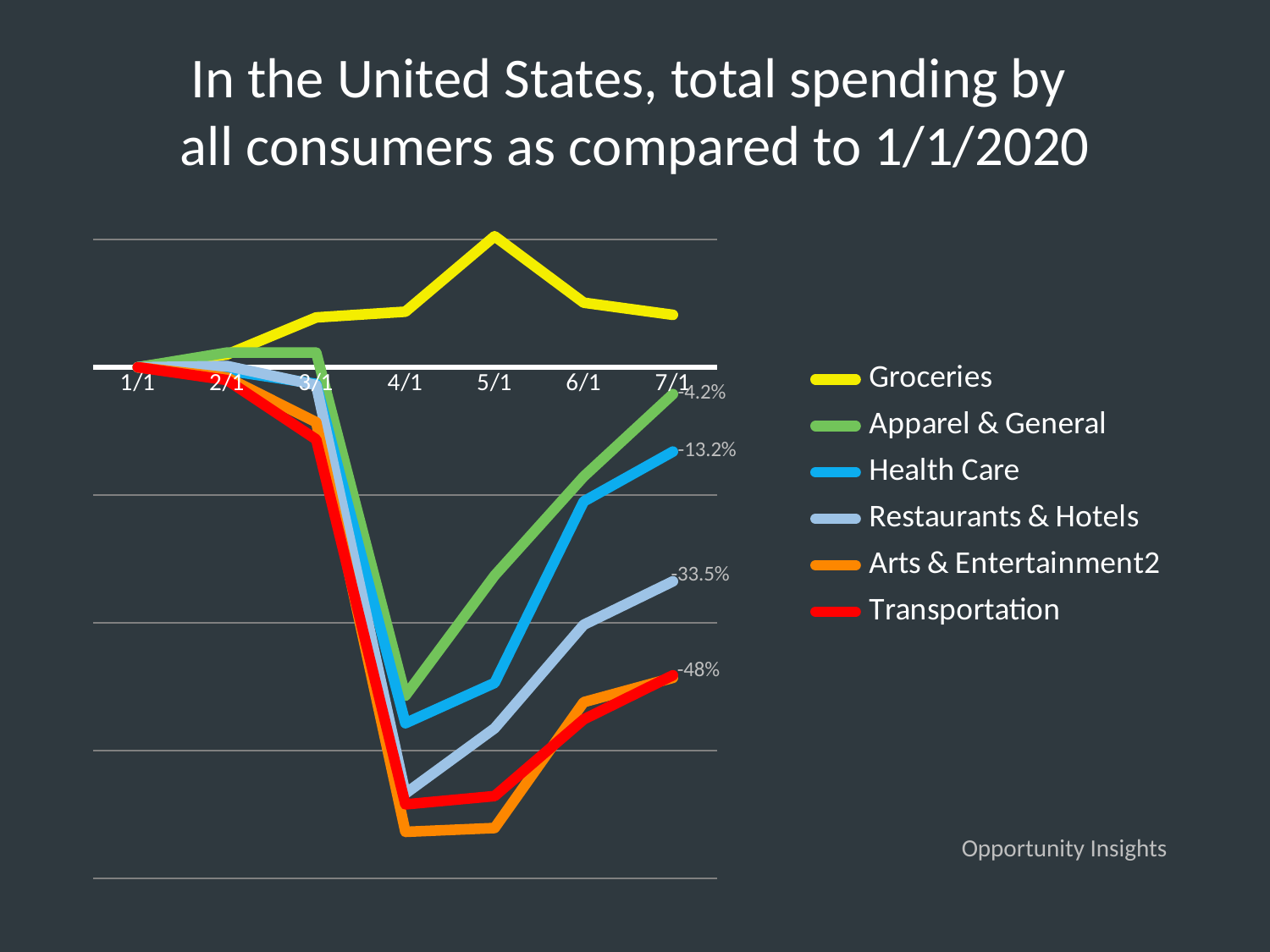
What is the value for Restaurants & Hotels at 7/1? -33.5% Which series has the lowest value at 4/1? Arts & Entertainment2 How many series does the legend list? 6 How many dates are shown along the x axis? 7 At 7/1, which is higher: Apparel & General or Health Care? Apparel & General Which series has the highest value at 5/1? Groceries Does the Health Care line rise or fall from 4/1 to 7/1? rise What colour is the Groceries line? yellow What is the value for Health Care at 7/1? -13.2% What is the value for Apparel & General at 7/1? -4.2% What kind of chart is shown on the slide? line chart At 7/1, how many percentage points higher is Apparel & General than Health Care? 9